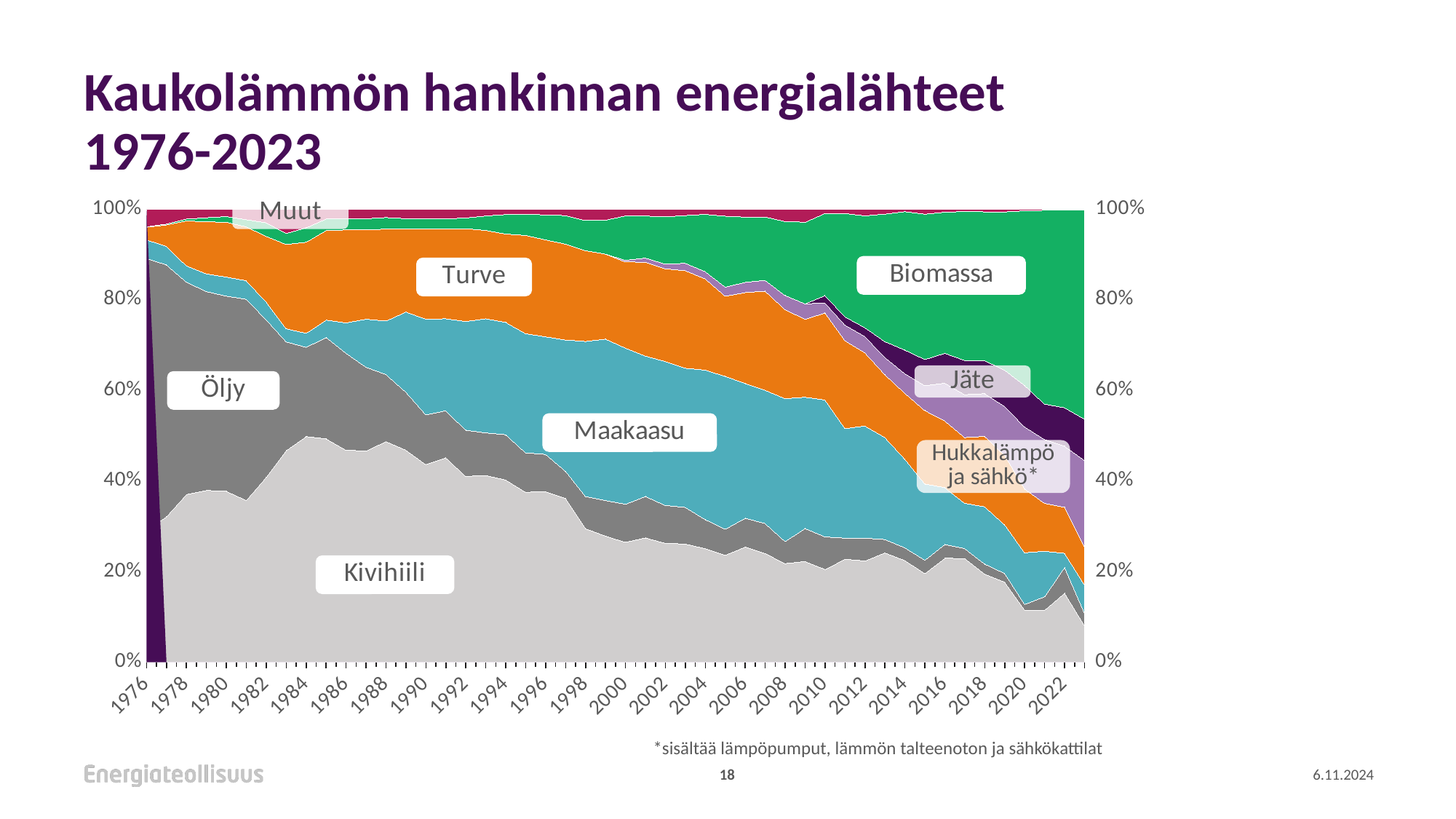
Which energy source has the largest share in 2023? Biomassa What is the highest value shown on the vertical axis? 100% Does the share of Öljy rise or fall from the late 1970s to 2023? Falls What kind of chart is shown on the slide? Stacked area chart What is the title of the chart? Kaukolämmön hankinnan energialähteet 1976-2023 Does the share of Biomassa rise or fall from the 1990s to 2023? Rises Is the share of Öljy in 1977 greater or less than 50%? greater Which energy source has the largest share in 1977? Öljy How many energy sources are labelled in the chart? 8 Is the share of Kivihiili in 2023 greater or less than 20%? less Which energy source has the largest share in 1990? Kivihiili Is the share of Biomassa in 2023 greater or less than 40%? greater